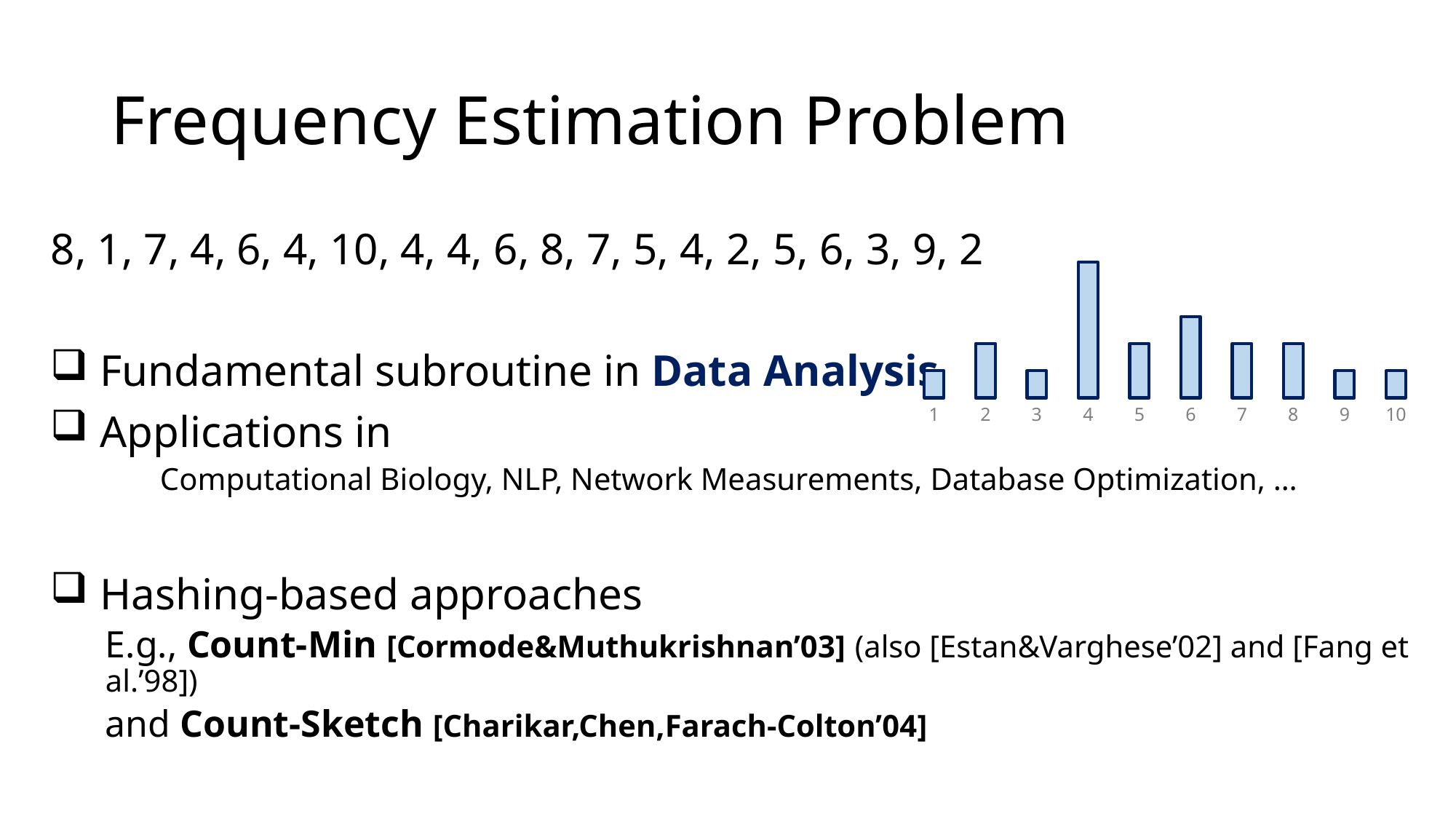
What colour are the bars in the chart? light blue Which category has the tallest bar in the chart? 4 What kind of chart is shown on the slide? bar chart Which bar is taller, category 1 or category 4? 4 Which bar is taller, category 6 or category 3? 6 Do the bar heights rise steadily from category 1 to category 10? no What is the first category label on the x axis of the chart? 1 Which bar is taller, category 2 or category 9? 2 Which category has the second tallest bar in the chart? 6 How many categories are shown on the x axis of the bar chart? 10